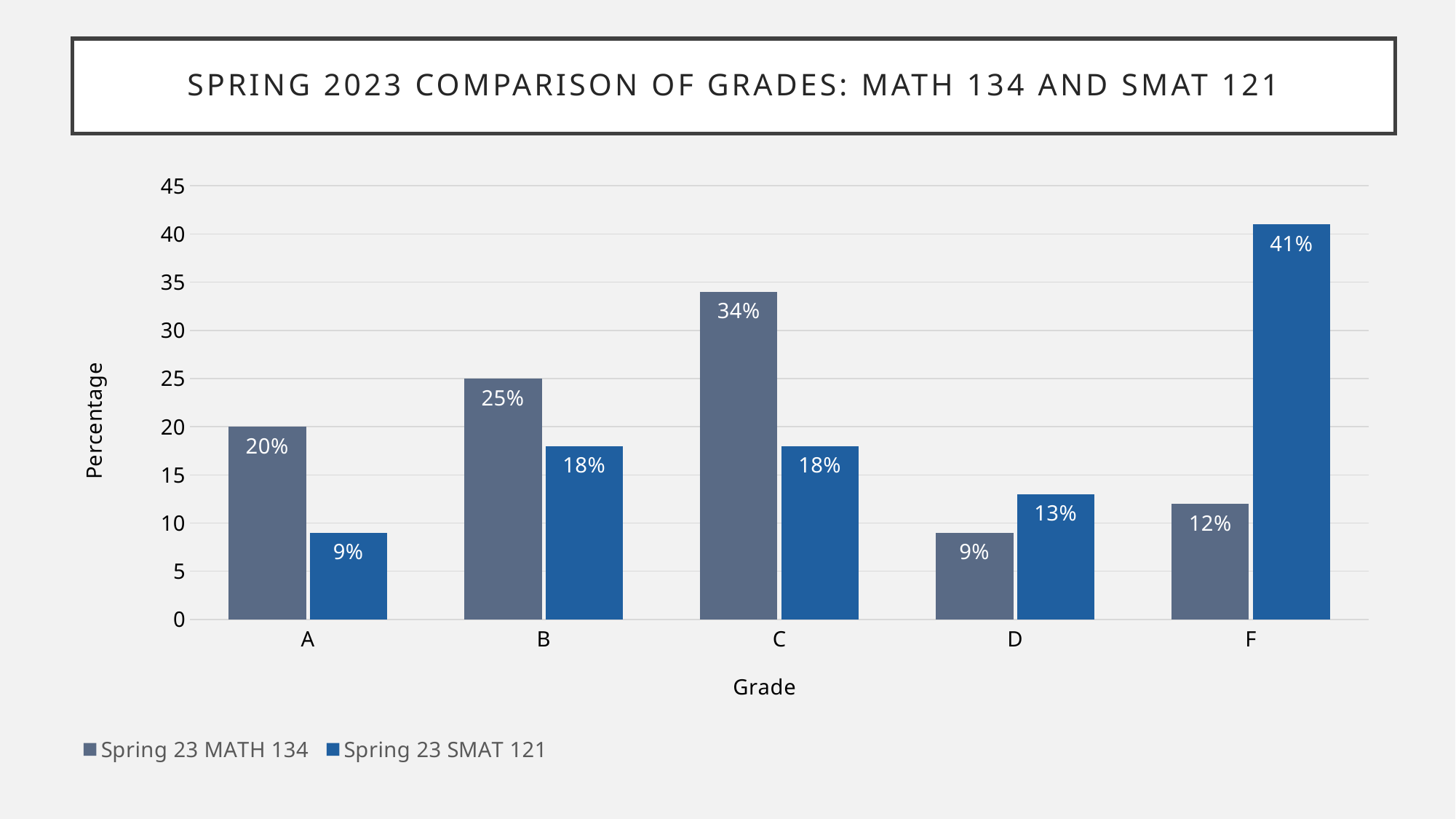
How many series does the legend list? 2 What percentage of Spring 23 SMAT 121 students received a grade of F? 41% What percentage of Spring 23 MATH 134 students received a grade of C? 34% What kind of chart is shown on the slide? Bar chart Which grade has the highest percentage for Spring 23 MATH 134? C What is the value for grade A in the Spring 23 SMAT 121 series? 9% Which grade has the lowest percentage for Spring 23 SMAT 121? A For grade B, which series has the larger value, Spring 23 MATH 134 or Spring 23 SMAT 121? Spring 23 MATH 134 What is the label of the y axis? Percentage For grade D, which series has the larger value, Spring 23 MATH 134 or Spring 23 SMAT 121? Spring 23 SMAT 121 What is the difference between the Spring 23 SMAT 121 and Spring 23 MATH 134 percentages for grade F? 29% How many grade categories are shown on the x axis? 5